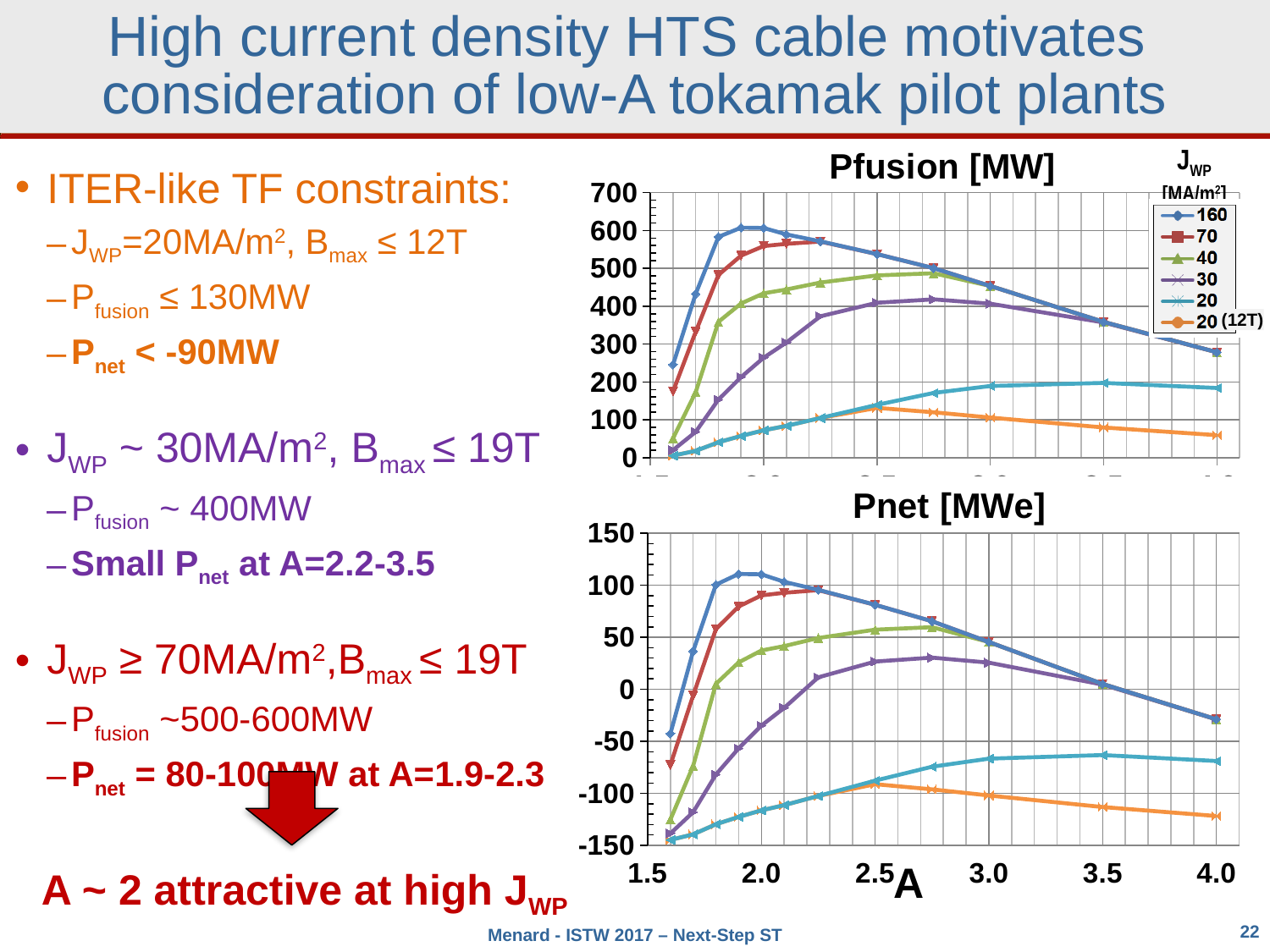
In the Pfusion [MW] chart, which series reaches the highest value? 160 In the Pfusion [MW] chart, does the 160 series rise or fall as A increases from 2.0 to 4.0? fall What is the x-axis label of the Pnet [MWe] chart? A In the Pfusion [MW] chart, which series has the lowest values at A=4.0? 20 (12T) In the Pnet [MWe] chart, is the value of the 20 (12T) series at A=4.0 greater or less than -100? less In the Pfusion [MW] chart, is the peak value of the 160 series greater or less than 500? greater In the Pnet [MWe] chart, which is larger at A=4.0: the 160 series or the 20 (12T) series? 160 How many series does the legend of the Pfusion [MW] chart list? 6 In the Pnet [MWe] chart, is the peak value of the 160 series greater or less than 100? greater What is the title of the lower chart? Pnet [MWe] What kind of chart is the Pfusion [MW] chart? line chart